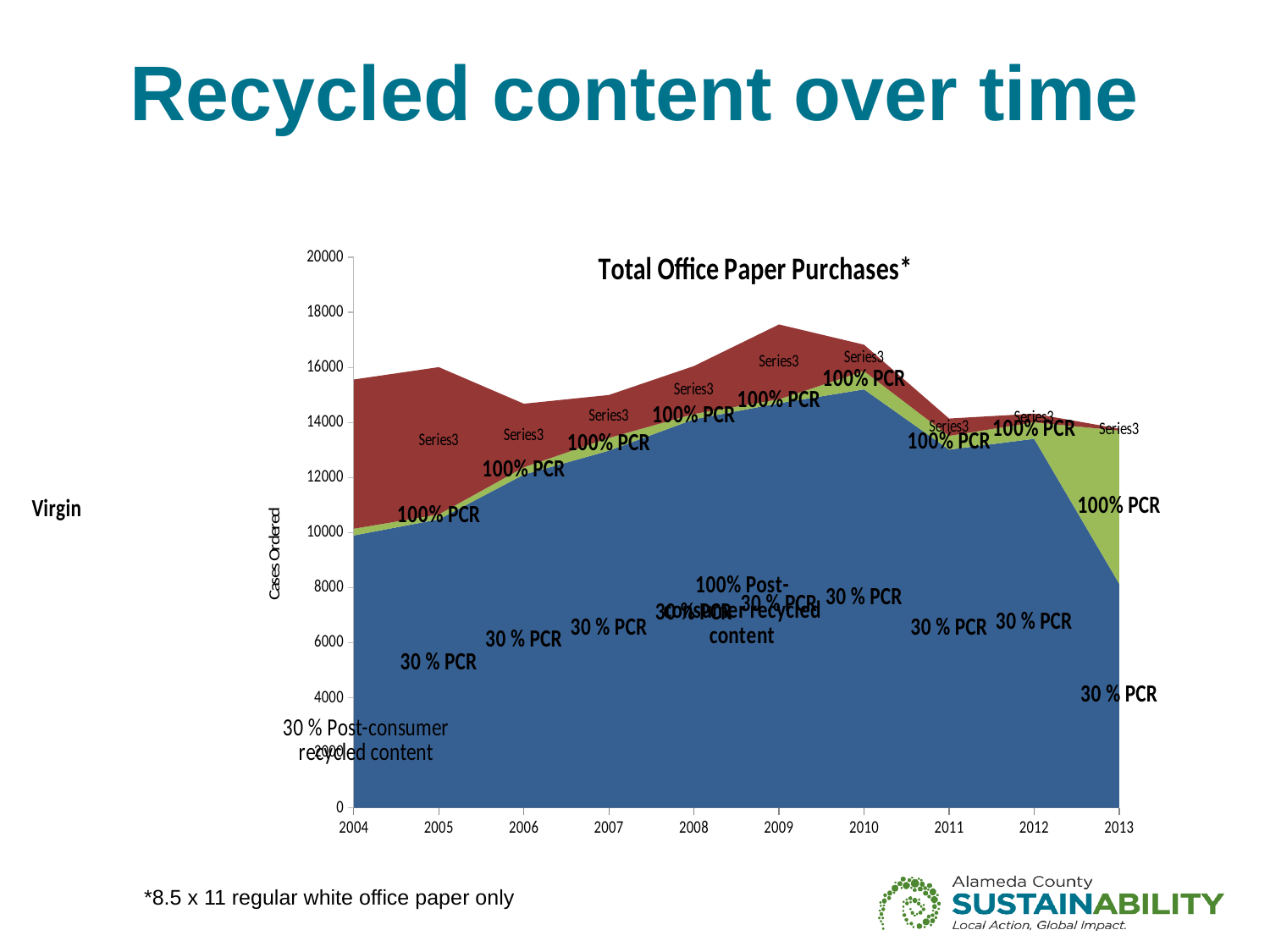
In which year is the total number of cases ordered highest? 2009 What is the title of the chart? Total Office Paper Purchases* Is the number of cases of 30 % PCR paper ordered in 2010 greater or less than 14000? greater Does the total number of cases ordered rise or fall from 2010 to 2013? fall What kind of chart is shown on the slide? Stacked area chart Is the total number of cases ordered in 2004 greater or less than 14000? greater How many years are shown along the x axis of the chart? 10 Which year has the larger total number of cases ordered, 2005 or 2009? 2009 What is the label on the vertical axis of the chart? Cases Ordered Is the number of cases of 30 % PCR paper ordered in 2013 greater or less than 10000? less Does the number of cases of 30 % PCR paper ordered rise or fall from 2004 to 2010? rise